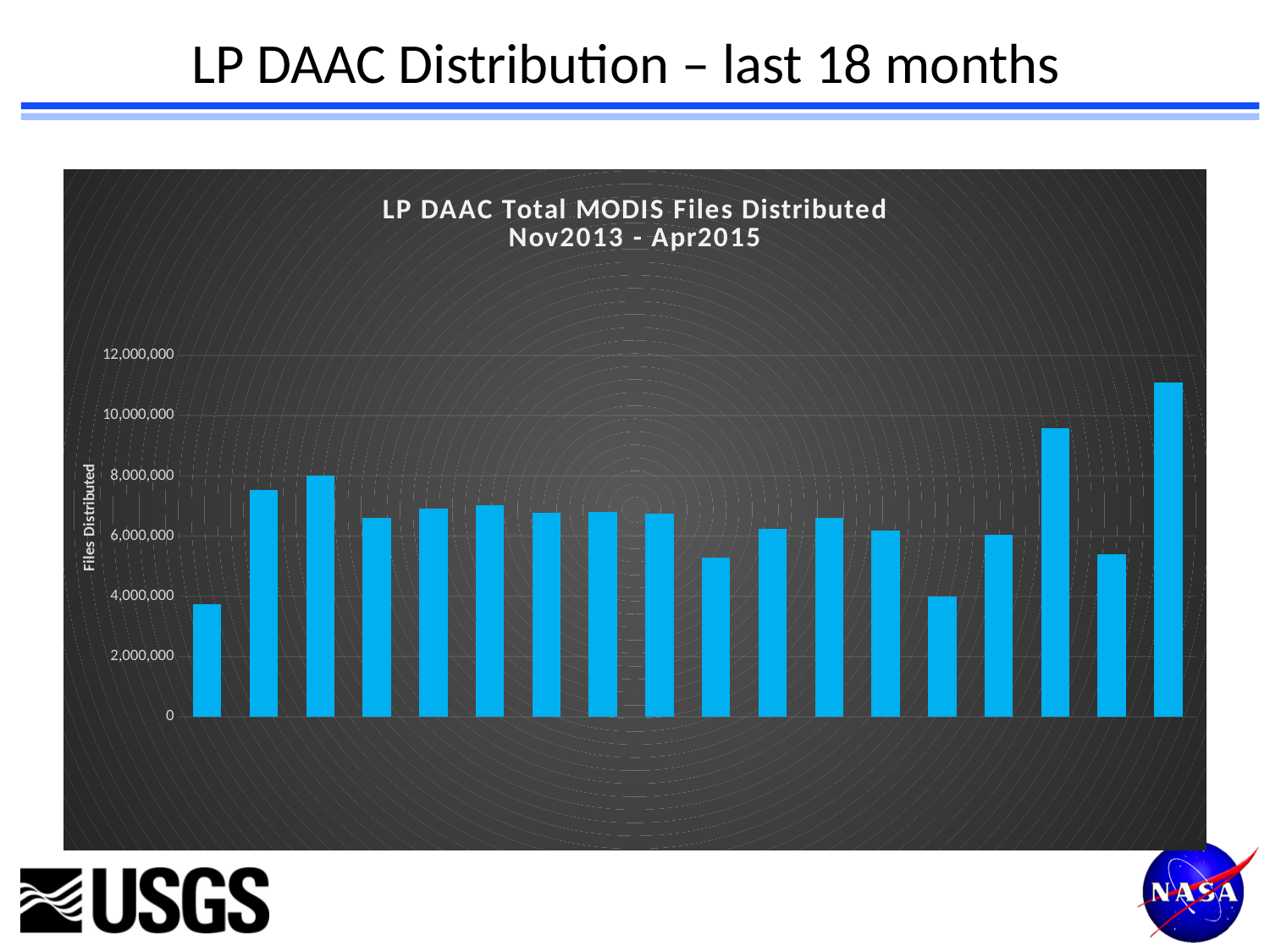
Which is larger, the leftmost bar or the rightmost bar? the rightmost bar How many bars are plotted in the chart? 18 Is the value of the second bar from the right greater or less than 6,000,000? less What is the label on the vertical axis of the chart? Files Distributed Is the value of the second bar from the left greater or less than 6,000,000? greater Is the value of the third bar from the right greater or less than 8,000,000? greater What is the highest value shown on the vertical axis? 12,000,000 Which bar is the tallest in the chart? the last (rightmost) bar What is the title of the chart? LP DAAC Total MODIS Files Distributed Nov2013 - Apr2015 What kind of chart is shown on the slide? bar chart